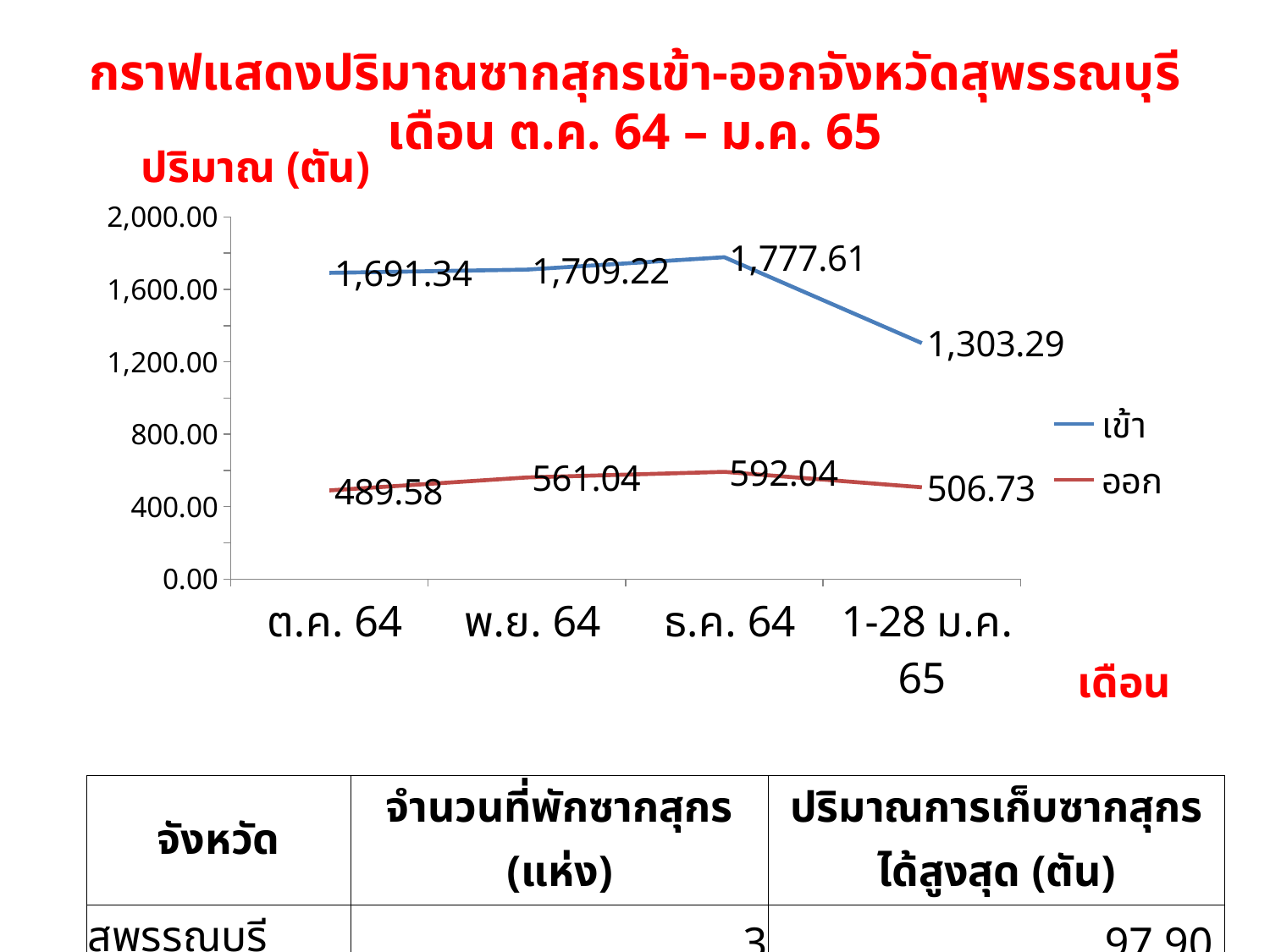
Which is larger in ธ.ค. 64, เข้า or ออก? เข้า How many months are plotted along the x axis? 4 What is the value of เข้า for ธ.ค. 64? 1,777.61 What is the label on the y axis of the chart? ปริมาณ (ตัน) What is the difference between เข้า and ออก in พ.ย. 64? 1,148.18 What is the value of ออก for ต.ค. 64? 489.58 In which month is the ออก series lowest? ต.ค. 64 Does the เข้า series rise or fall from ธ.ค. 64 to 1-28 ม.ค. 65? fall In which month is the เข้า series highest? ธ.ค. 64 What type of chart is shown on the slide? line chart What is the value of เข้า for 1-28 ม.ค. 65? 1,303.29 How many series does the legend list? 2